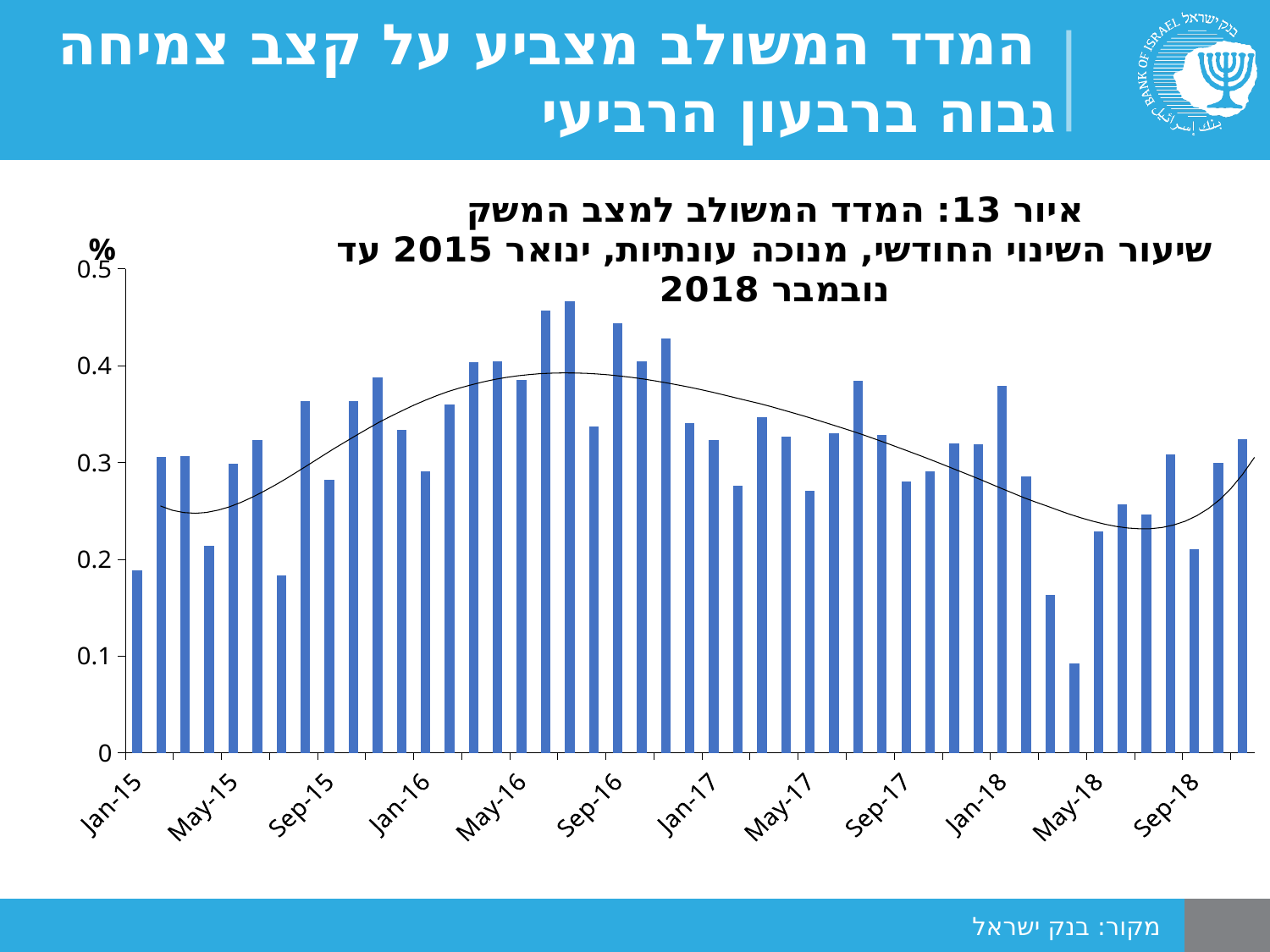
Is the value for Jan-18 greater or less than 0.3? greater Does the smoothed trend line rise or fall between Sep-16 and May-18? fall Is the lowest bar in the chart greater or less than 0.1? less What unit is shown at the top of the vertical axis? % Which is larger, the value for Sep-16 or the value for Jan-15? Sep-16 Which is larger, the value for Jan-18 or the value for May-18? Jan-18 Is the value for Sep-16 greater or less than 0.4? greater What kind of chart is shown on the slide? bar chart What is the title of the chart (the figure number)? איור 13: המדד המשולב למצב המשק